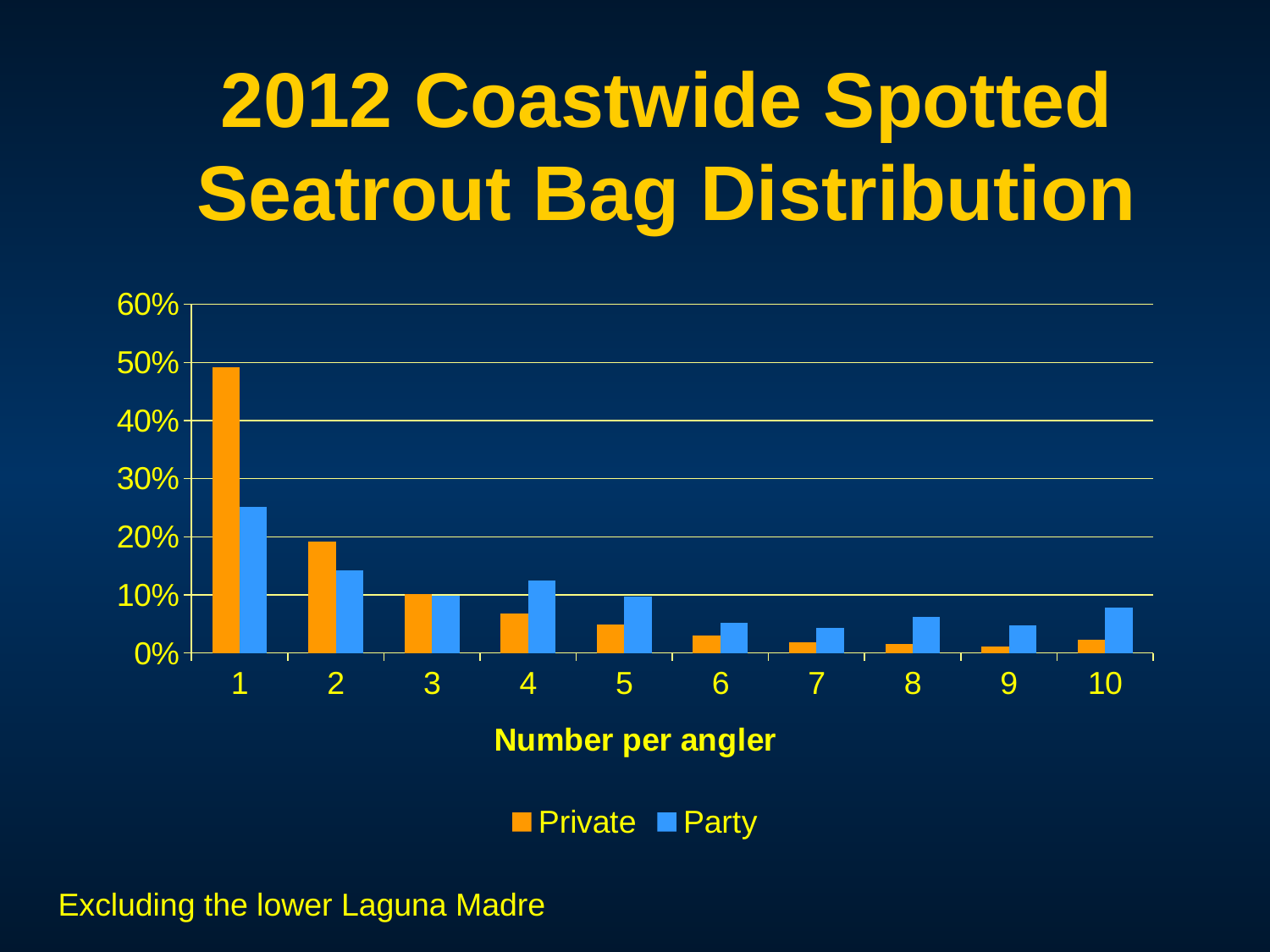
For which number per angler is the Private value highest? 1 How many series does the legend list? 2 For which number per angler is the Private value lowest? 9 How many categories are shown along the x axis? 10 Which series is shown in orange? Private At 1 per angler, which series has the larger value, Private or Party? Private Is the Private value for 1 per angler greater or less than 40%? greater What kind of chart is shown on the slide? bar chart What is the title of the x axis? Number per angler For which number per angler is the Party value highest? 1 Is the Party value for 4 per angler greater or less than 10%? greater At 10 per angler, which series has the larger value, Private or Party? Party